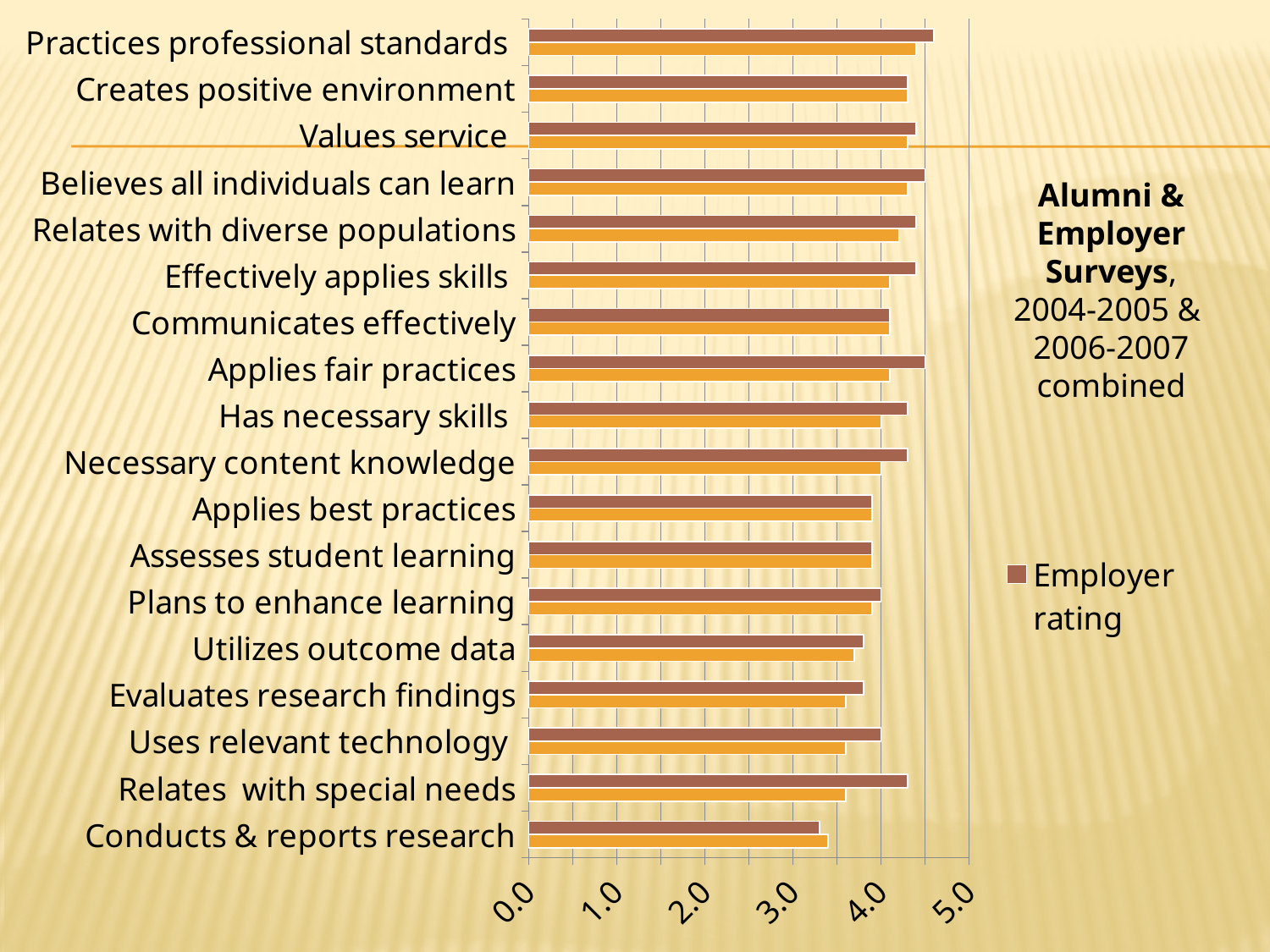
Is the Employer rating for Utilizes outcome data greater or less than 4.0? less Which category has the lowest Employer rating? Conducts & reports research Which has the larger Employer rating: Practices professional standards or Conducts & reports research? Practices professional standards What is the legend entry shown for the chart? Employer rating How many entries does the chart's legend list? 1 What colour are the Employer rating bars in the chart? brown Is the Employer rating for Relates with special needs greater or less than 4.0? greater How many categories are listed on the vertical axis of the chart? 18 Which has the larger Employer rating: Relates with special needs or Evaluates research findings? Relates with special needs Is the Employer rating for Practices professional standards greater or less than 4.0? greater What kind of chart is shown on the slide? bar chart